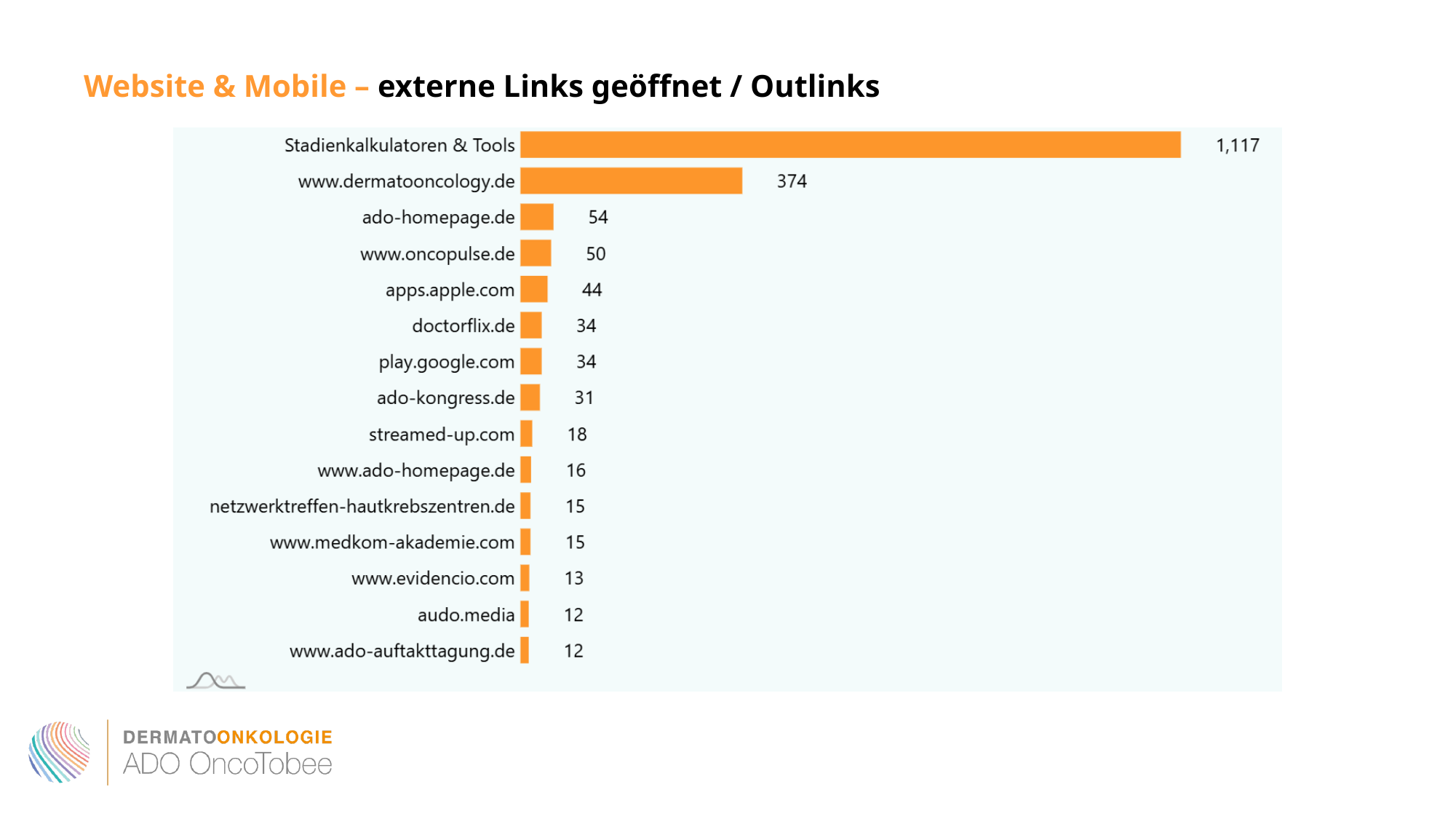
What is the value for streamed-up.com? 18 How many categories are shown in the chart? 15 What kind of chart is shown on the slide? Bar chart Which category has the highest value? Stadienkalkulatoren & Tools Which is larger, the value for www.dermatooncology.de or the value for ado-homepage.de? www.dermatooncology.de What is the value for www.dermatooncology.de? 374 What is the difference between the values for ado-homepage.de and www.oncopulse.de? 4 What colour are the bars in the chart? Orange Which is larger, the value for doctorflix.de or the value for ado-kongress.de? doctorflix.de What is the difference between the values for Stadienkalkulatoren & Tools and www.dermatooncology.de? 743 What is the value for Stadienkalkulatoren & Tools? 1,117 What is the value for apps.apple.com? 44